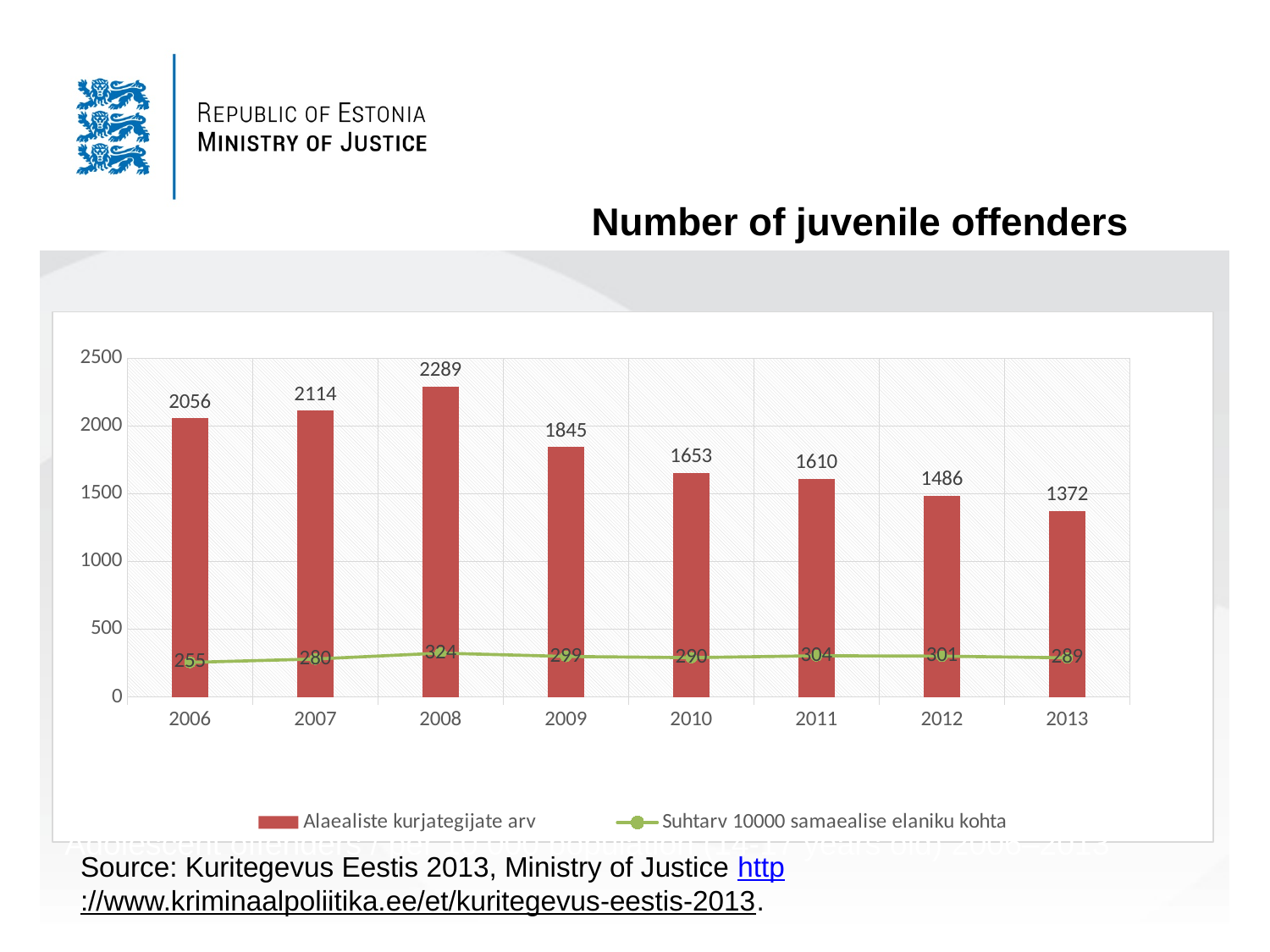
Is the number of juvenile offenders in 2012 greater or less than 1500? less How many years are shown on the x axis of the chart? 8 Which year has the lowest number of juvenile offenders? 2013 What is the value of the Suhtarv 10000 samaealise elaniku kohta series in 2011? 304 How many series does the legend list? 2 What kind of chart is used to show the number of juvenile offenders? bar chart Which year has the highest number of juvenile offenders? 2008 Which year has a higher number of juvenile offenders, 2009 or 2010? 2009 What is the number of juvenile offenders (Alaealiste kurjategijate arv) in 2008? 2289 Does the number of juvenile offenders rise or fall from 2008 to 2013? fall What is the difference between the number of juvenile offenders in 2006 and in 2013? 684 What is the title of the chart? Number of juvenile offenders